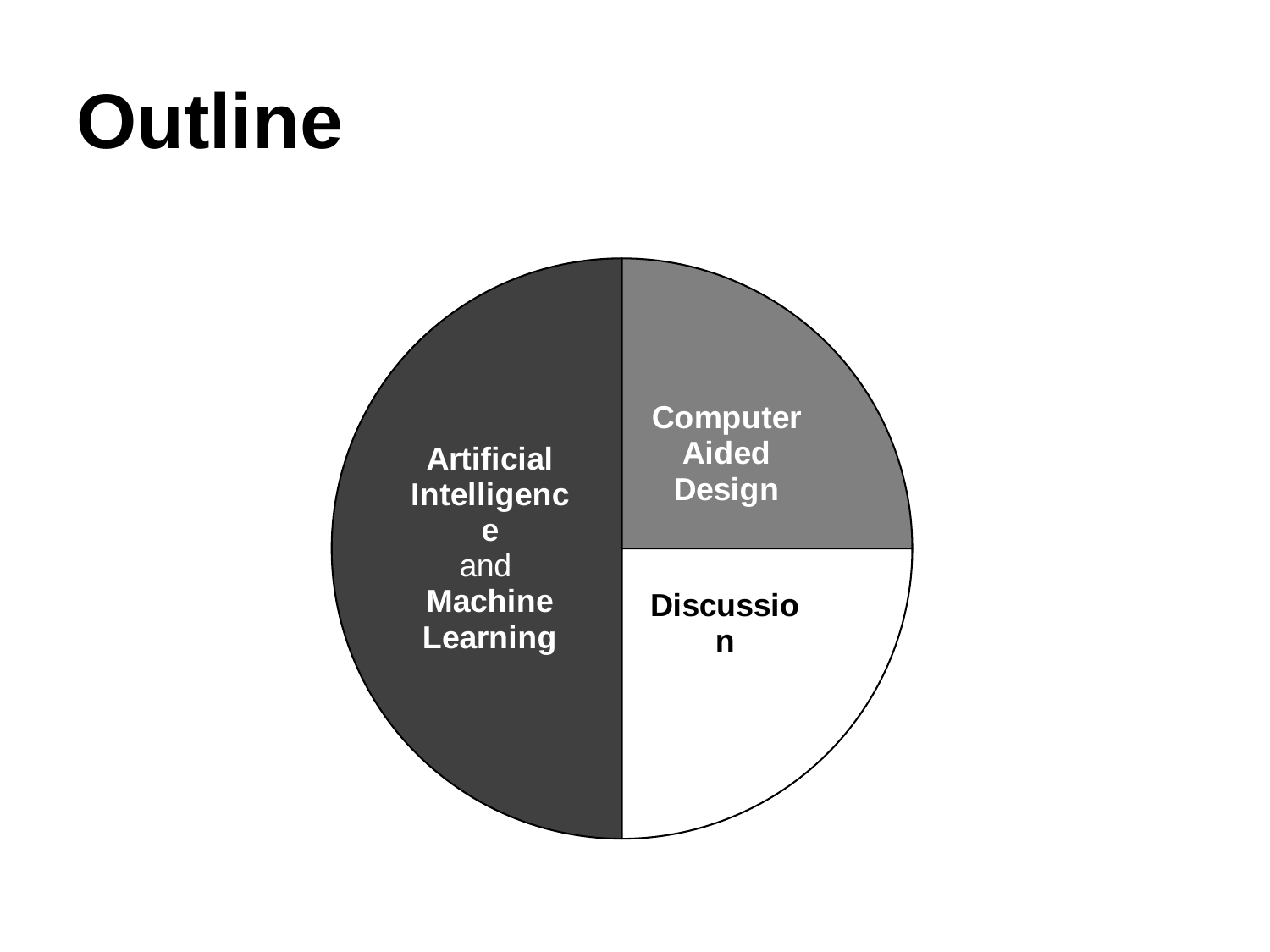
Which slice of the pie chart is the largest? Artificial Intelligence and Machine Learning What is the title of the slide containing the pie chart? Outline How many slices does the pie chart have? 3 What kind of chart is shown on the slide? pie chart Which slice is larger, Discussion or Artificial Intelligence and Machine Learning? Artificial Intelligence and Machine Learning Which slice of the pie chart is coloured white? Discussion Which slice is larger, Artificial Intelligence and Machine Learning or Computer Aided Design? Artificial Intelligence and Machine Learning